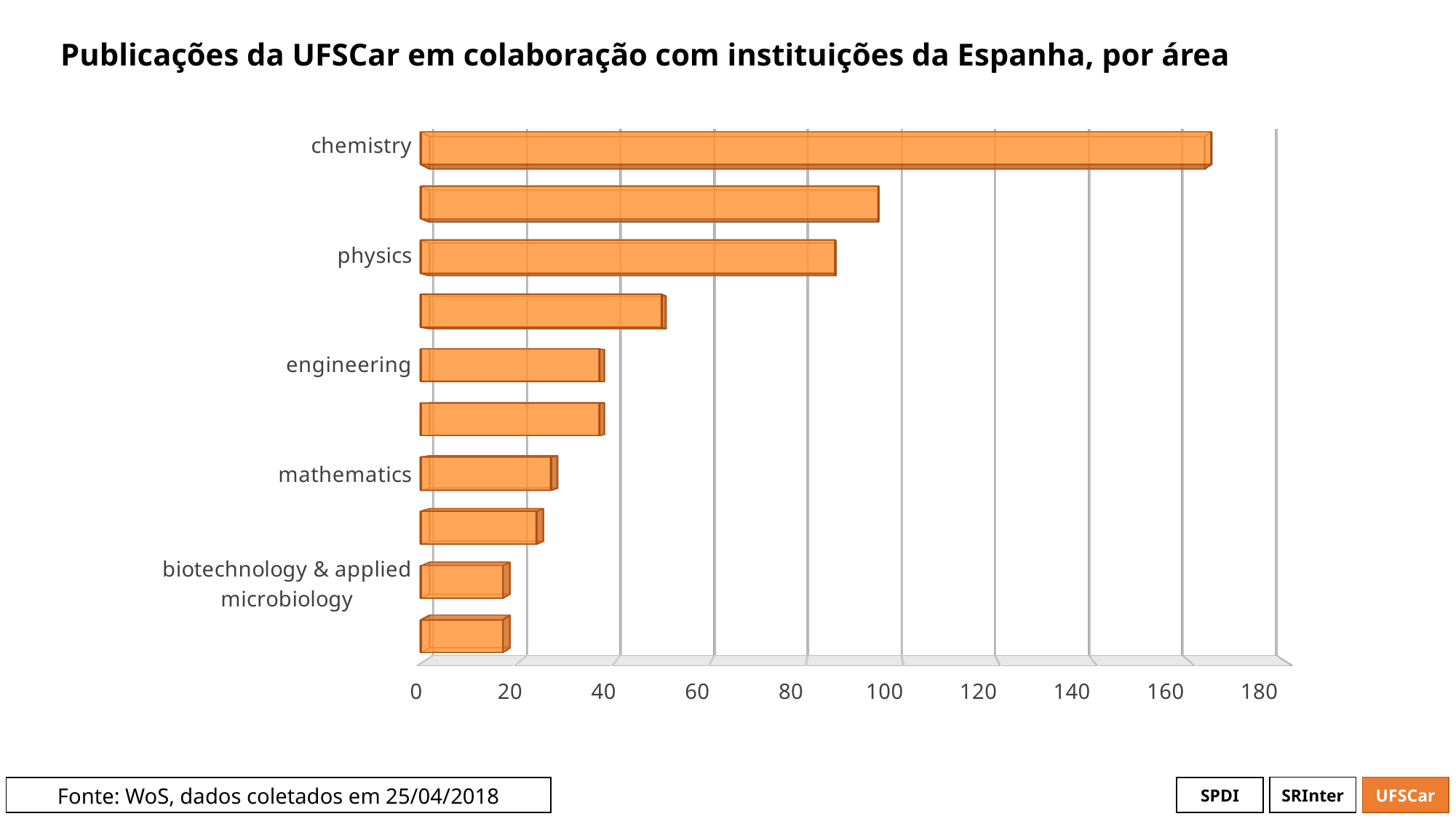
Is the value for physics greater or less than 80? greater Is the value for biotechnology & applied microbiology greater or less than 40? less Is the value for physics greater or less than 100? less How many bars does the chart contain? 10 Which has more publications, chemistry or physics? chemistry What kind of chart is shown on the slide? bar chart Which has more publications, engineering or mathematics? engineering What is the title of the chart? Publicações da UFSCar em colaboração com instituições da Espanha, por área Which area has the highest number of publications? chemistry